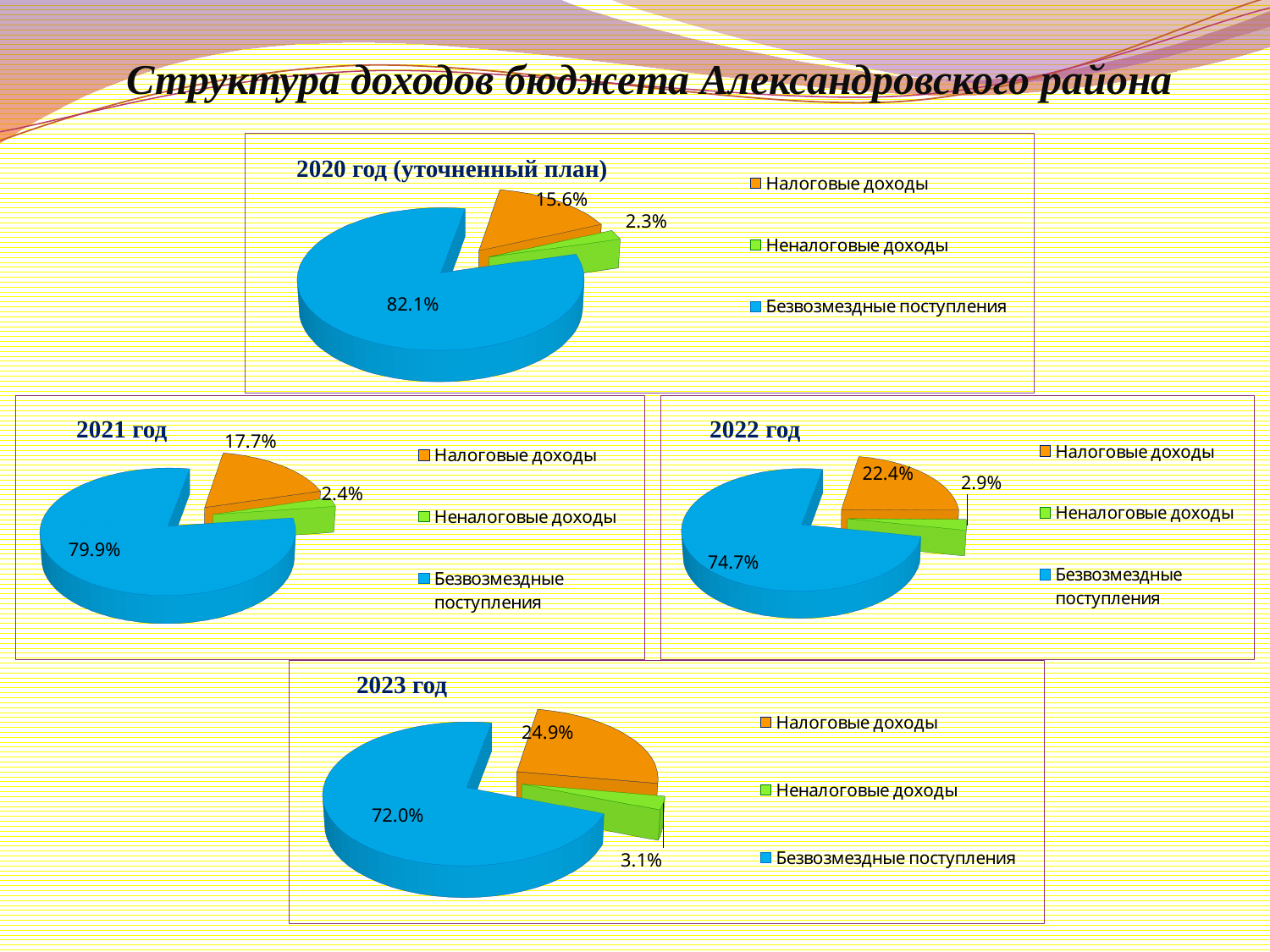
In the chart titled "2020 год (уточненный план)", what share is shown for Безвозмездные поступления? 82.1% What kind of chart is the chart titled "2023 год"? Pie chart In the chart titled "2022 год", what share is shown for Неналоговые доходы? 2.9% How many categories does the chart titled "2021 год" show? 3 In the chart titled "2020 год (уточненный план)", what colour is the slice for Налоговые доходы? Orange In the chart titled "2023 год", what share is shown for Безвозмездные поступления? 72.0% In the chart titled "2021 год", what share is shown for Налоговые доходы? 17.7% In the chart titled "2023 год", which category has the largest slice? Безвозмездные поступления In the chart titled "2022 год", what is the difference between the shares of Безвозмездные поступления and Налоговые доходы? 52.3% How many entries does the legend of the chart titled "2022 год" list? 3 In the chart titled "2020 год (уточненный план)", which category has the smallest slice? Неналоговые доходы Which is larger: the share of Налоговые доходы in the "2021 год" chart or in the "2023 год" chart? 2023 год